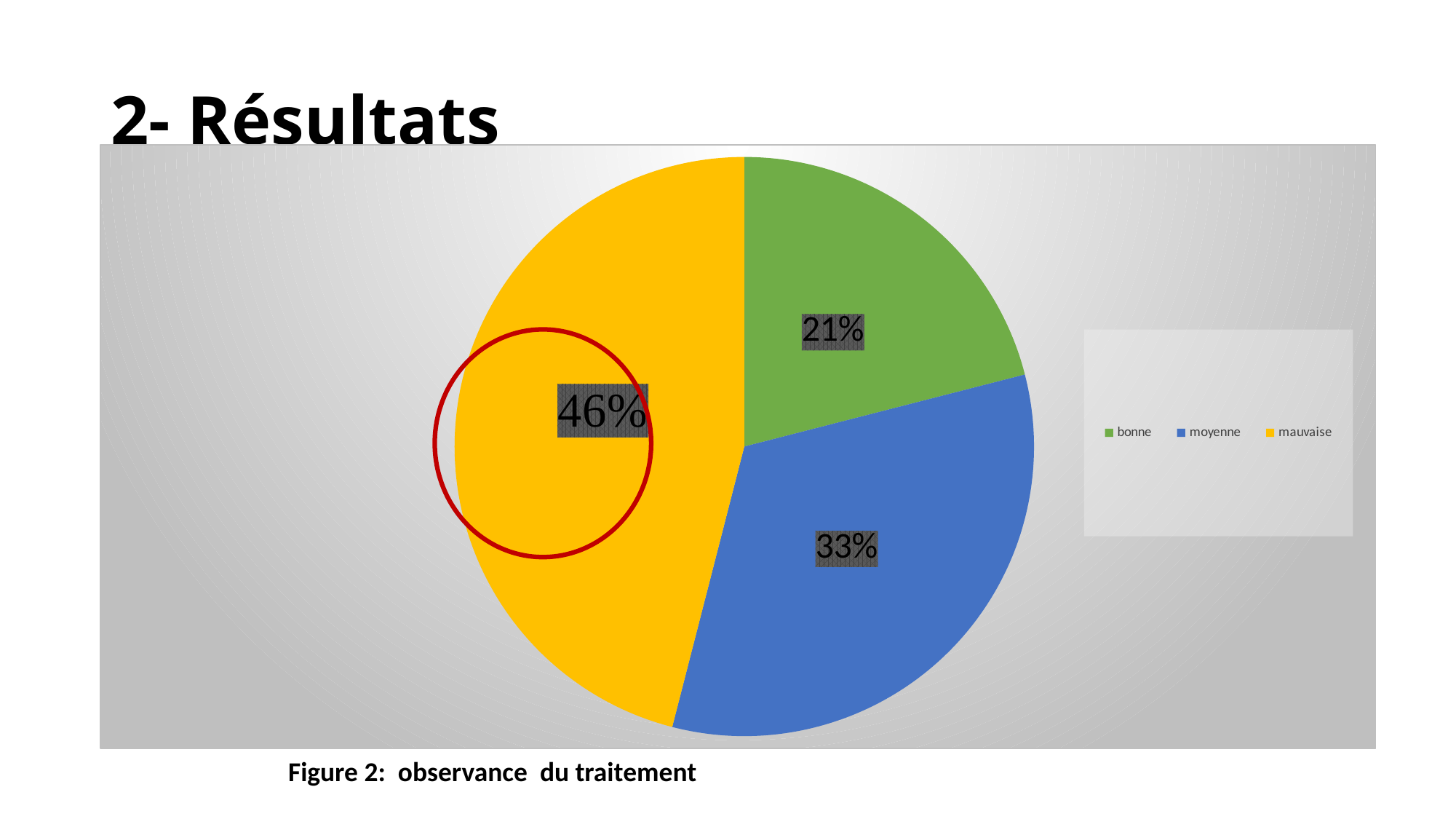
What is the difference in percentage points between the 'mauvaise' and 'bonne' slices? 25 What is the difference in percentage points between the 'moyenne' and 'bonne' slices? 12 How many entries does the legend list? 3 What percentage is shown for the 'mauvaise' slice? 46% Which category has the largest share of the pie? mauvaise How many slices does the pie chart have? 3 What percentage is shown for the 'bonne' slice? 21% What percentage is shown for the 'moyenne' slice? 33% Which is larger, the 'moyenne' slice or the 'bonne' slice? moyenne What colour is the 'moyenne' slice? blue Which category has the smallest share of the pie? bonne What kind of chart is shown on the slide? pie chart